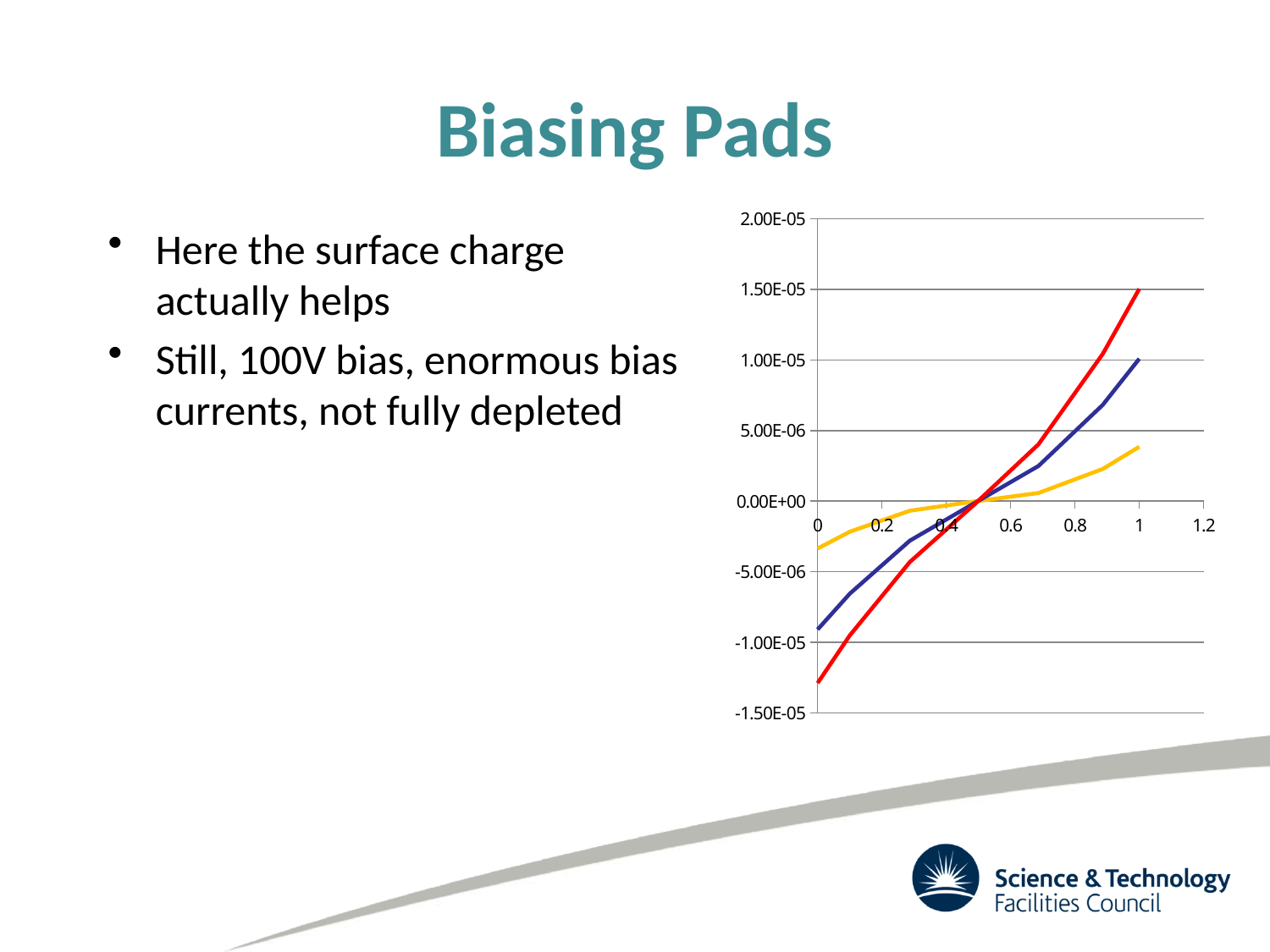
At x = 0, is the value of the red line greater or less than -1.00E-05? less At x = 1, which line has the larger value, the red line or the blue line? the red line At x = 1, is the value of the red line greater or less than 1.00E-05? greater How many lines are plotted on the chart? 3 At x = 0, is the value of the yellow line greater or less than -5.00E-06? greater What kind of chart is shown on the slide? line chart Do the values of the red line rise or fall as x increases from 0 to 1? rise Do the values of the yellow line rise or fall as x increases from 0 to 1? rise Which line reaches the highest value on the chart? the red line What is the highest value labelled on the y axis of the chart? 2.00E-05 Which line reaches the lowest value on the chart? the red line